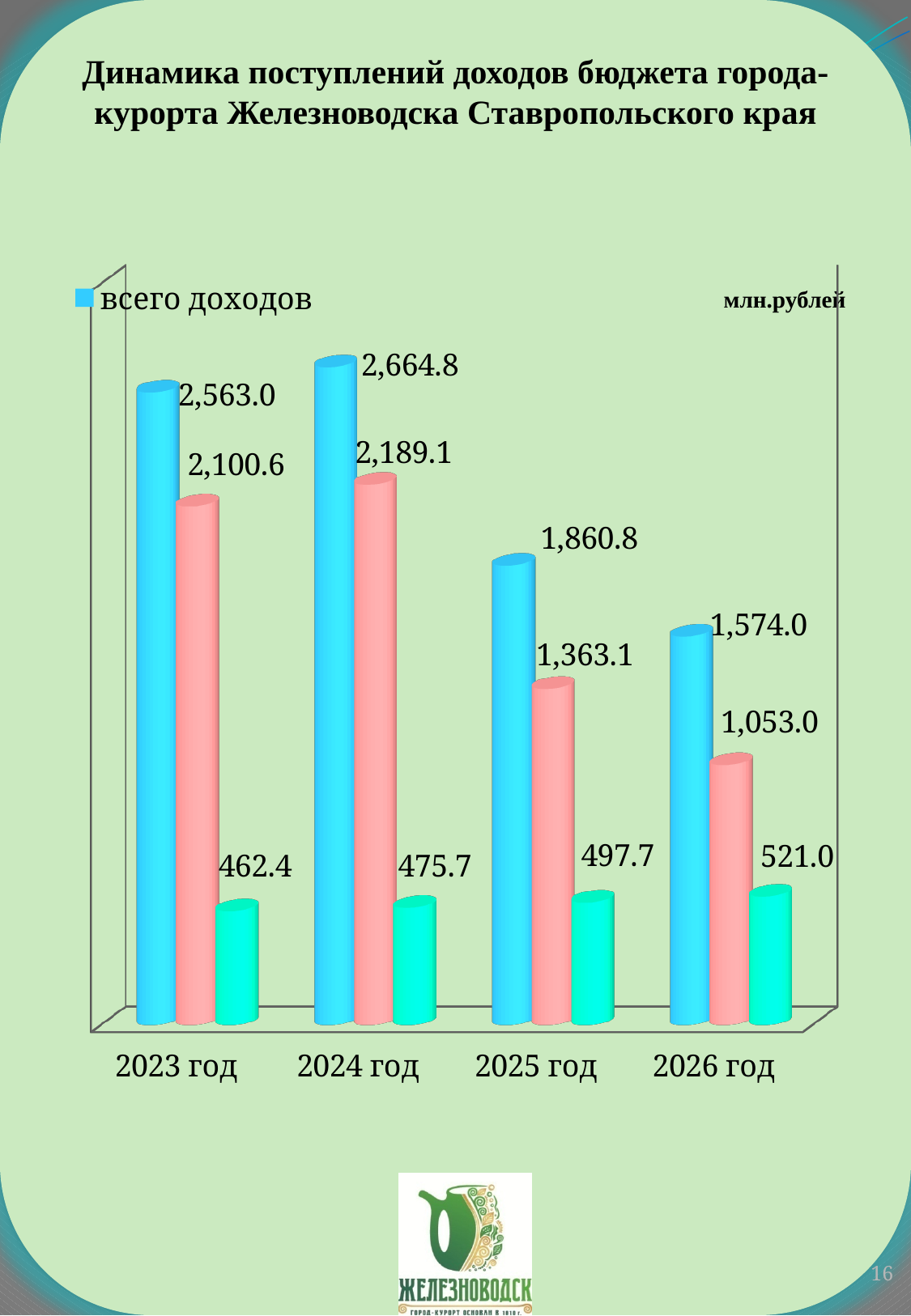
How many years are shown on the x axis? 4 In which year is всего доходов the lowest? 2026 год Which year has the larger value on the pink (middle) bar, 2023 год or 2024 год? 2024 год What kind of chart is shown on the slide? bar chart Do the values of the green (third) bars rise or fall from 2023 год to 2026 год? rise How many series does the legend list? 1 What is the value shown on the green (third) bar for 2025 год? 497.7 In which year is всего доходов the highest? 2024 год What is the value of всего доходов for 2026 год? 1,574.0 What unit of measurement is indicated on the chart? млн.рублей What is the difference between всего доходов in 2024 год and 2023 год? 101.8 What is the value of всего доходов for 2024 год? 2,664.8